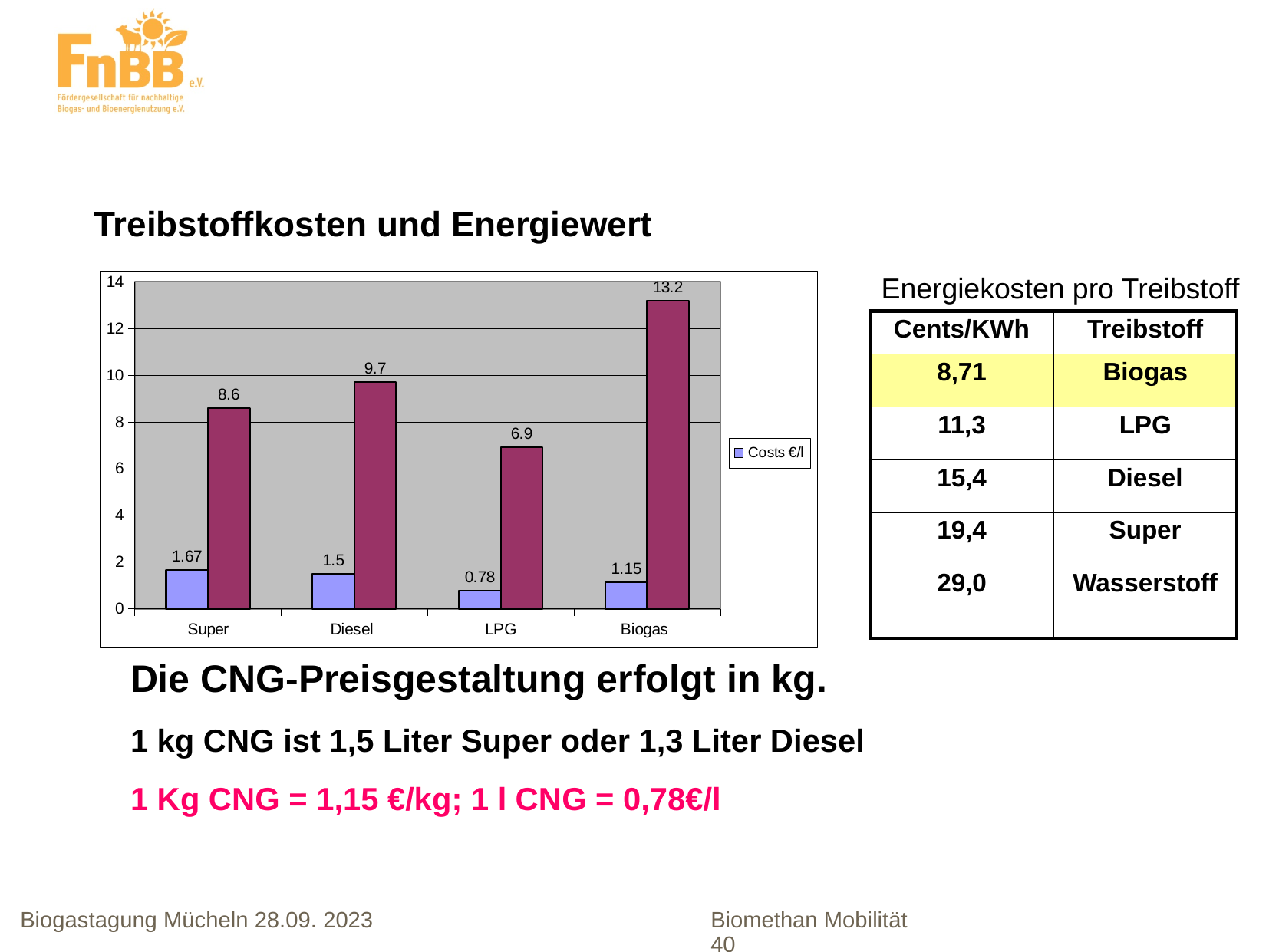
What is the value of the dark red bar for Biogas in the bar chart? 13.2 Which is larger in the bar chart: the Costs €/l value for Diesel or for Biogas? Diesel What is the Costs €/l value for Super in the bar chart? 1.67 Which category has the lowest Costs €/l value in the bar chart? LPG What type of chart is shown on the slide? Bar chart How many series does the legend of the bar chart list? 1 What is the Costs €/l value for LPG in the bar chart? 0.78 Which category has the tallest dark red bar in the bar chart? Biogas What is the difference between the dark red bar values for Biogas and Super in the bar chart? 4.6 What is the value of the dark red bar for Diesel in the bar chart? 9.7 Which category has the highest Costs €/l value in the bar chart? Super How many categories are shown on the x axis of the bar chart? 4